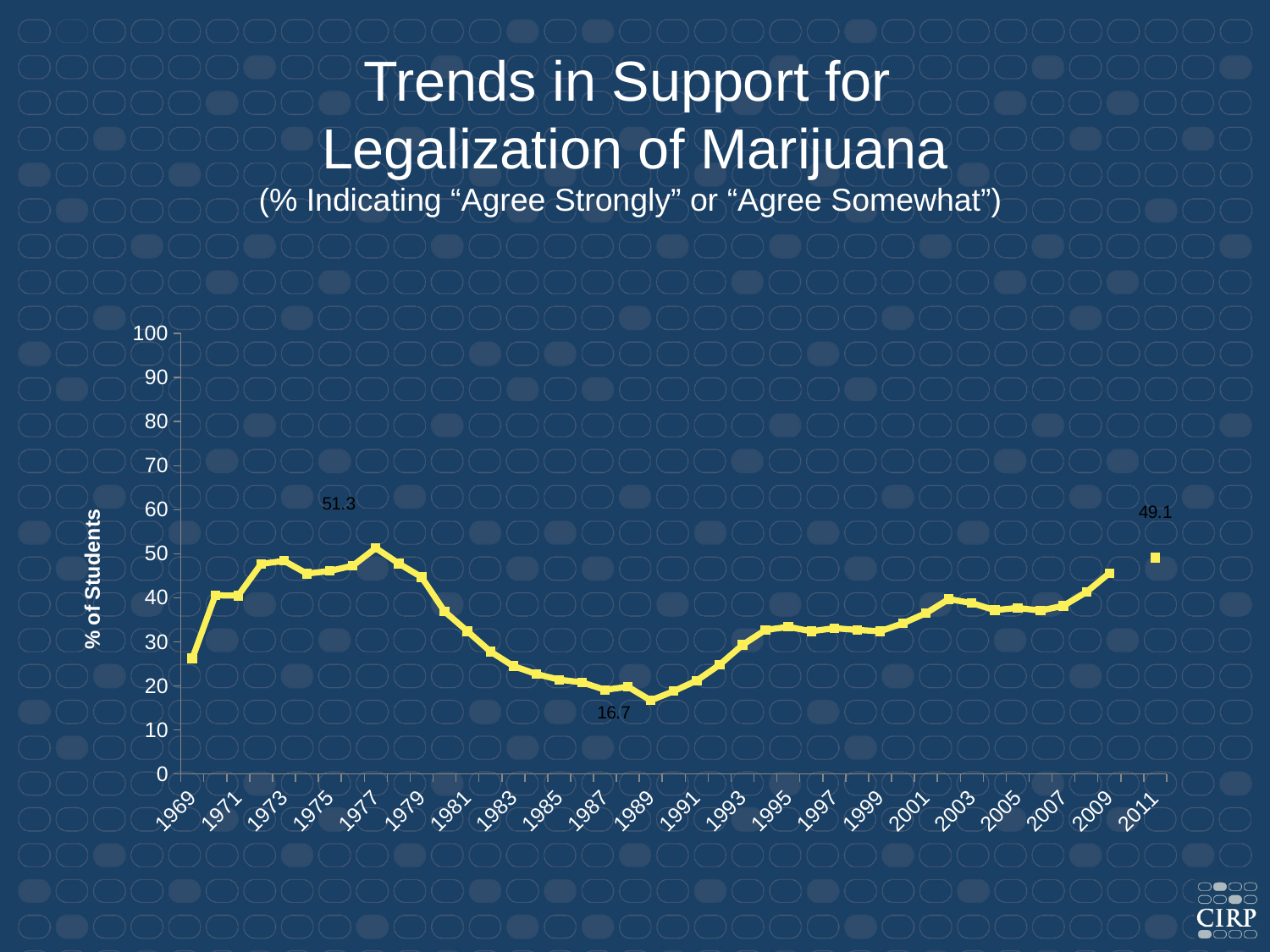
Is the value for 1969 greater or less than 30? less What type of chart is shown on the slide? line chart What is the value shown for 2011? 49.1 What is the lowest value labelled on the chart? 16.7 Is the value for 2009 greater or less than 40? greater Is the value for 1981 greater or less than 30? greater How much lower is the 2011 value (49.1) than the peak value of 51.3? 2.2 What is the label on the vertical axis? % of Students Does the line rise or fall between 1977 and 1989? fall What is the highest value labelled on the chart? 51.3 What is the difference between the highest labelled value (51.3) and the lowest labelled value (16.7)? 34.6 In which year does the line reach its lowest point? 1989